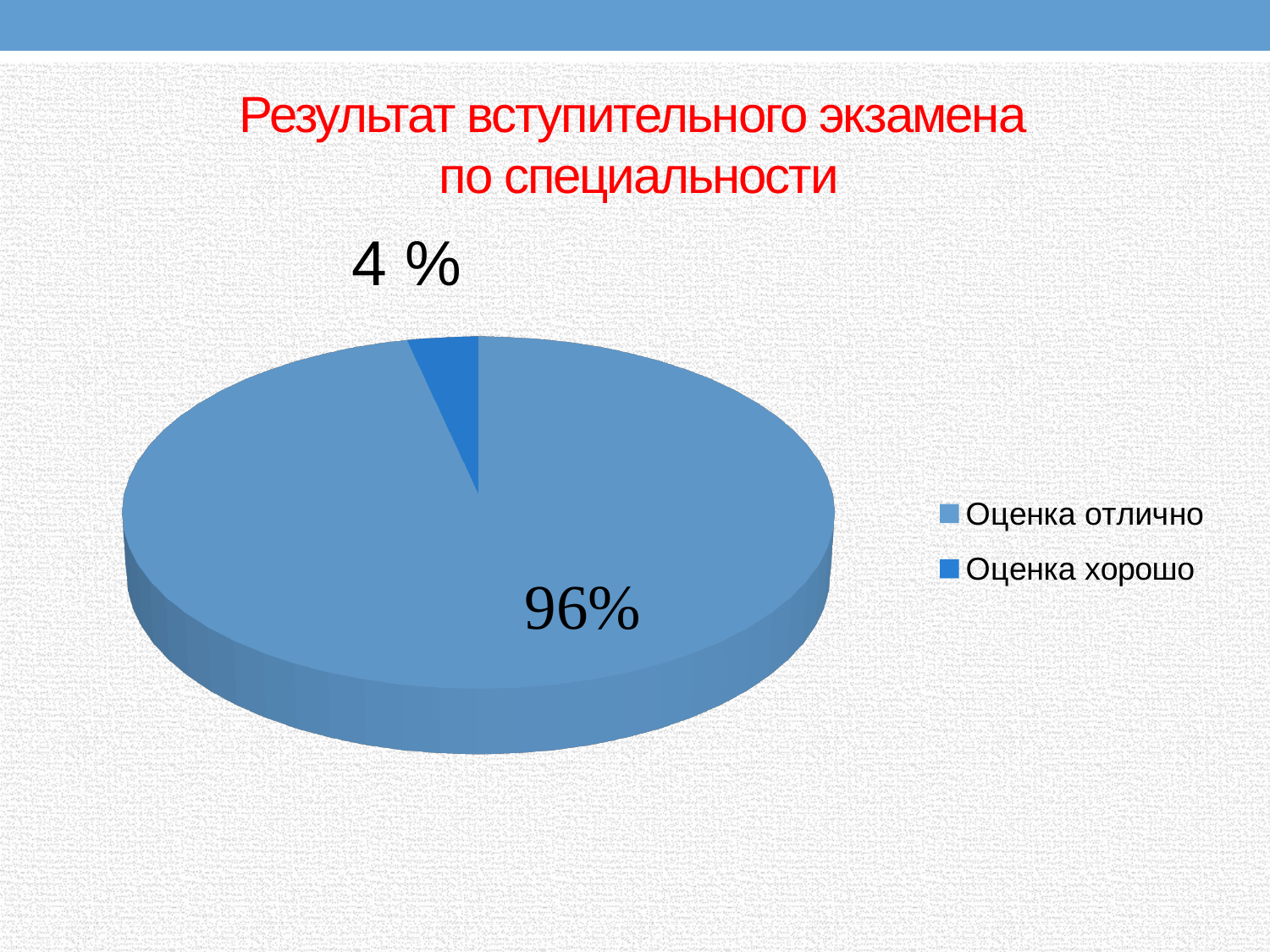
What share of the pie does "Оценка отлично" represent? 96% Which legend entry is listed first? Оценка отлично What share of the pie does "Оценка хорошо" represent? 4 % Which category has the smallest slice of the pie? Оценка хорошо What kind of chart is shown on the slide? Pie chart What is the difference in percentage points between the "Оценка отлично" and "Оценка хорошо" slices? 92 What is the title of the slide? Результат вступительного экзамена по специальности Which slice is larger, "Оценка отлично" or "Оценка хорошо"? Оценка отлично How many entries does the legend list? 2 How many categories are shown in the pie chart? 2 Which category has the largest slice of the pie? Оценка отлично